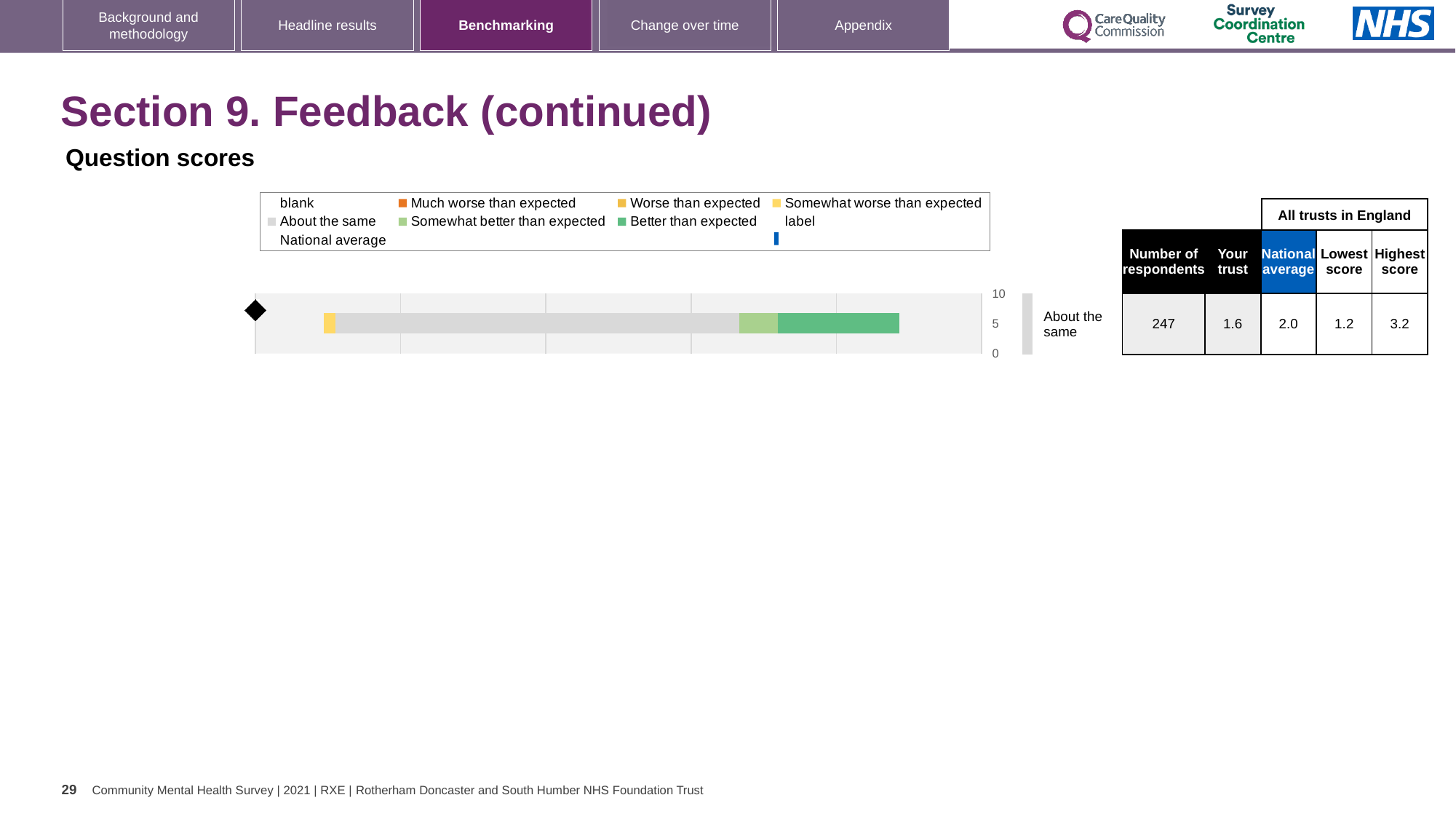
In the table next to the chart, what is the score for 'Your trust'? 1.6 Which colour does the legend use for 'Better than expected'? Green What kind of chart is shown on the slide? Stacked bar chart In the table next to the chart, what is the lowest score among all trusts in England? 1.2 How many bars are plotted in the chart? 1 In the table next to the chart, what is the difference between the national average and the 'Your trust' score? 0.4 In the table next to the chart, which is larger: the 'Your trust' score or the national average? National average In the table next to the chart, what is the highest score among all trusts in England? 3.2 In the table next to the chart, what is the number of respondents? 247 What is the category label shown to the right of the bar in the chart? About the same In the table next to the chart, what is the difference between the highest score and the lowest score? 2.0 In the table next to the chart, what is the national average score? 2.0